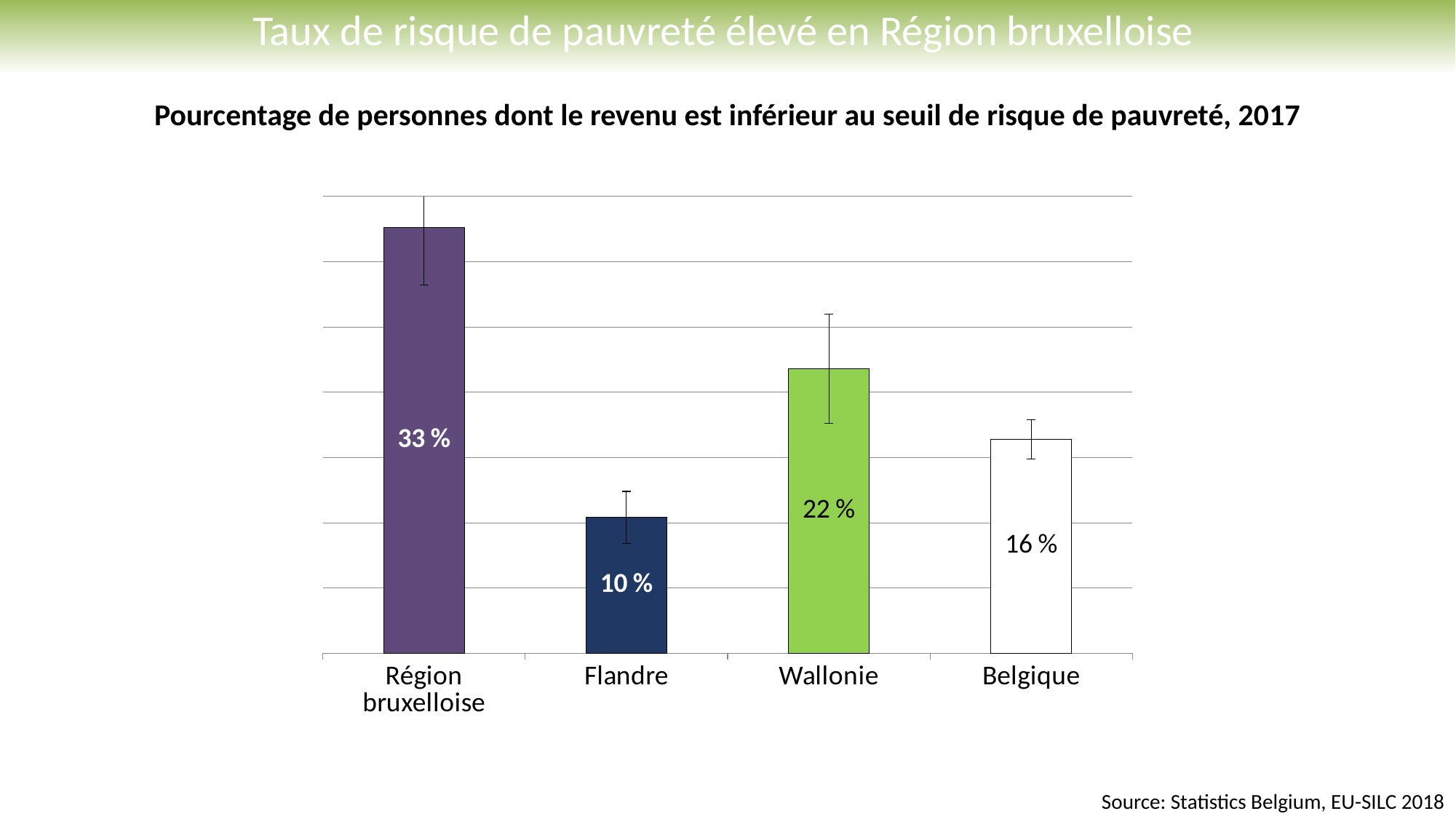
What is the value for Wallonie? 22 % What is the value for Belgique? 16 % What is the value for Région bruxelloise? 33 % What is the title of the chart? Pourcentage de personnes dont le revenu est inférieur au seuil de risque de pauvreté, 2017 What is the difference between the values for Région bruxelloise and Flandre? 23 % What kind of chart is shown on the slide? Bar chart Which is larger, the value for Wallonie or the value for Belgique? Wallonie What is the difference between the values for Wallonie and Belgique? 6 % Which category has the lowest value? Flandre What is the value for Flandre? 10 % How many categories are shown on the x axis? 4 Which category has the highest value? Région bruxelloise